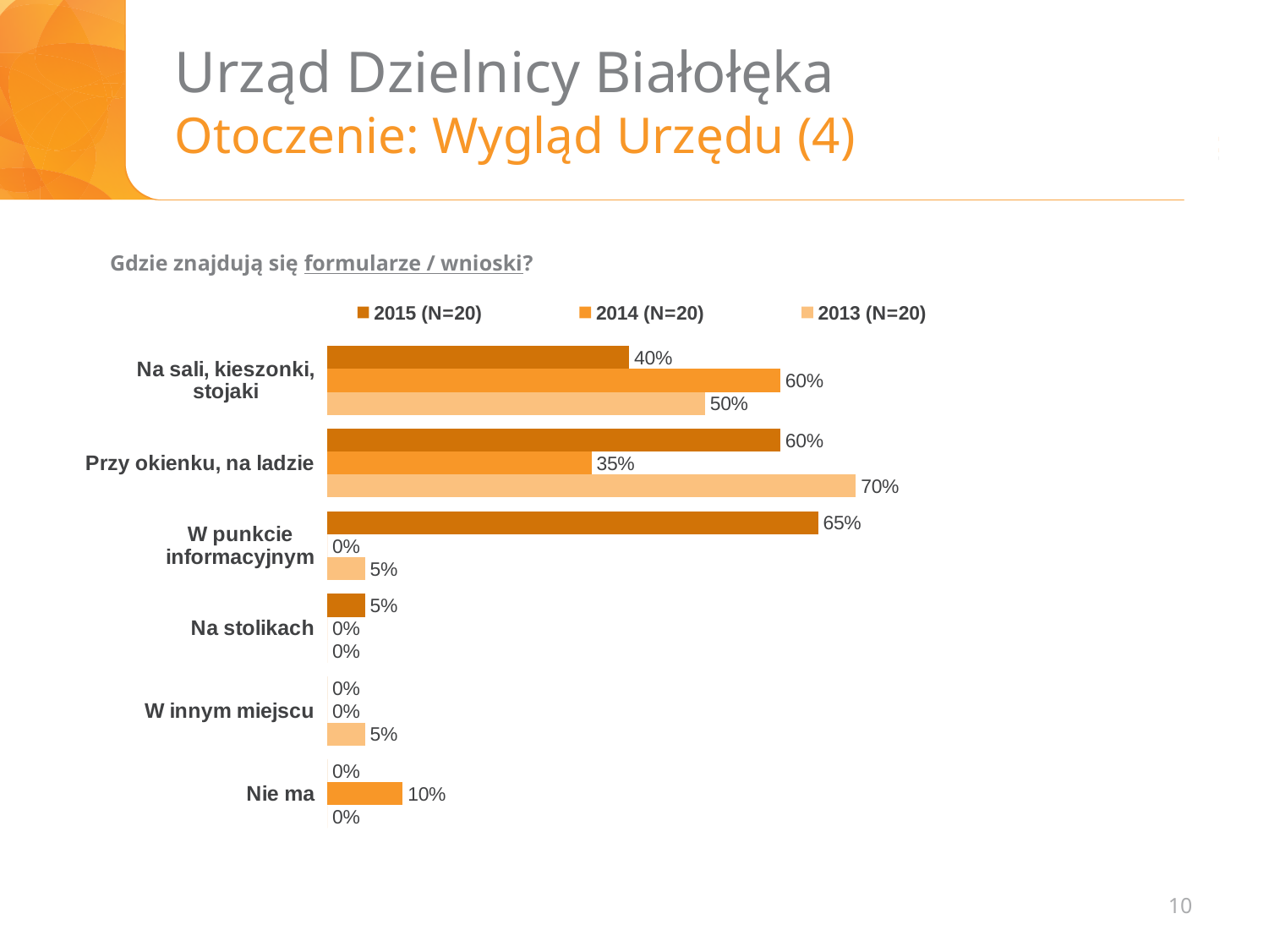
What is the value for "Na sali, kieszonki, stojaki" in the 2015 (N=20) series? 40% How many series does the legend list? 3 Which is larger for "Na sali, kieszonki, stojaki": the 2014 value or the 2013 value? 2014 What question does the chart answer, as stated above it? Gdzie znajdują się formularze / wnioski? What is the difference between the 2015 and 2014 values for "Przy okienku, na ladzie"? 25 percentage points Which category has the highest value in the 2015 (N=20) series? W punkcie informacyjnym What kind of chart is shown on the slide? Bar chart What is the value for "Przy okienku, na ladzie" in the 2013 (N=20) series? 70% How many categories are shown on the chart? 6 What is the value for "Nie ma" in the 2014 (N=20) series? 10% What is the value for "W punkcie informacyjnym" in the 2015 (N=20) series? 65% Which category has the highest value in the 2013 (N=20) series? Przy okienku, na ladzie